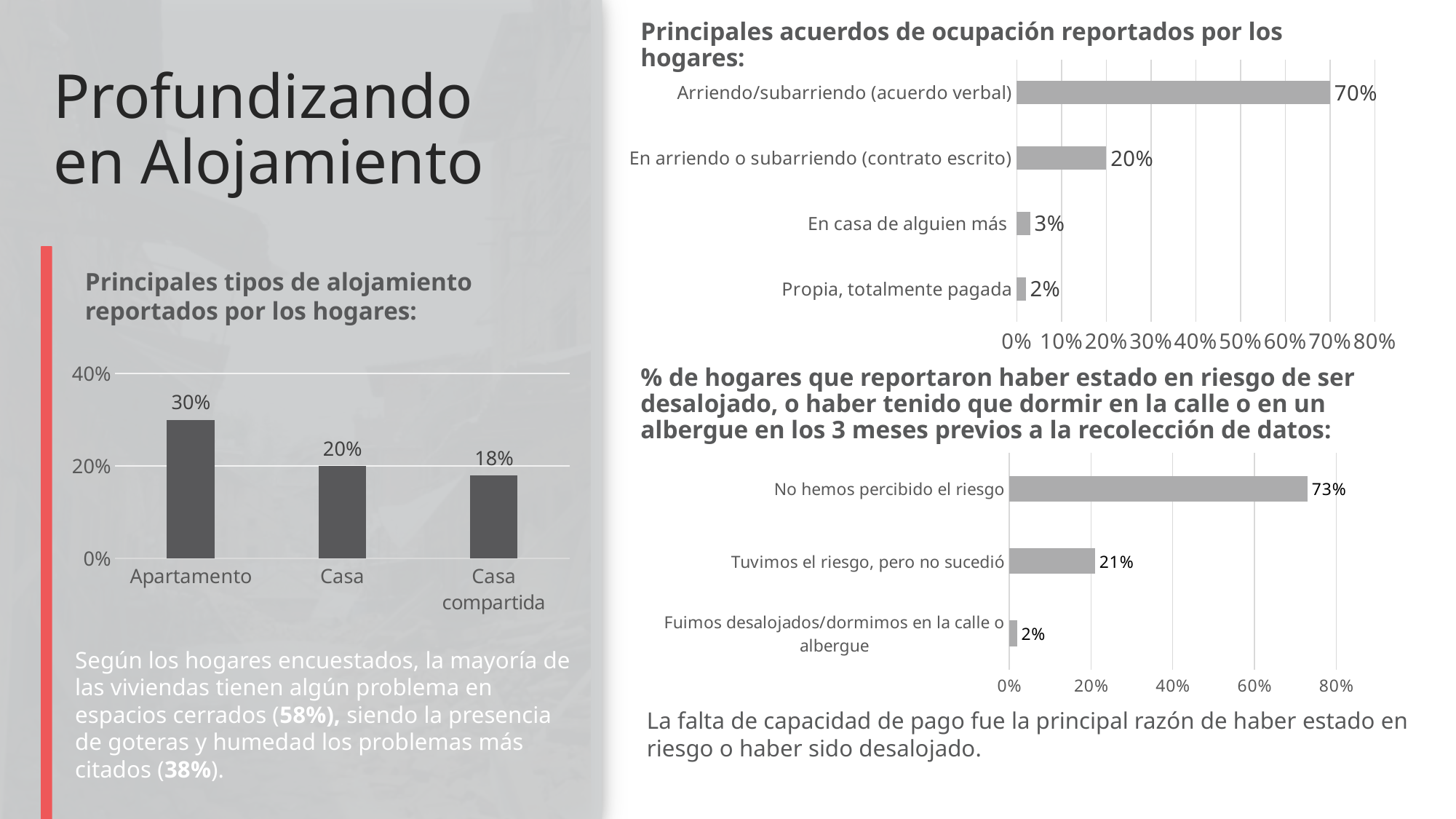
In the chart 'Principales acuerdos de ocupación reportados por los hogares', which category has the highest value? Arriendo/subarriendo (acuerdo verbal) In the bottom-right chart about households at risk of being evicted, which category has the lowest value? Fuimos desalojados/dormimos en la calle o albergue In the chart 'Principales tipos de alojamiento reportados por los hogares', which category has the lowest value? Casa compartida In the chart 'Principales acuerdos de ocupación reportados por los hogares', what is the difference between 'Arriendo/subarriendo (acuerdo verbal)' and 'En arriendo o subarriendo (contrato escrito)'? 50% How many categories are shown in the chart 'Principales tipos de alojamiento reportados por los hogares'? 3 In the bottom-right chart about households at risk of being evicted, what is the value for 'Tuvimos el riesgo, pero no sucedió'? 21% What kind of chart is 'Principales acuerdos de ocupación reportados por los hogares'? Bar chart In the chart 'Principales tipos de alojamiento reportados por los hogares', what is the value for Apartamento? 30% In the chart 'Principales acuerdos de ocupación reportados por los hogares', what is the value for 'En arriendo o subarriendo (contrato escrito)'? 20% In the chart 'Principales tipos de alojamiento reportados por los hogares', what is the difference between Apartamento and Casa? 10% How many categories are shown in the bottom-right chart about households at risk of being evicted? 3 In the bottom-right chart about households at risk of being evicted, which is larger: 'No hemos percibido el riesgo' or 'Tuvimos el riesgo, pero no sucedió'? No hemos percibido el riesgo